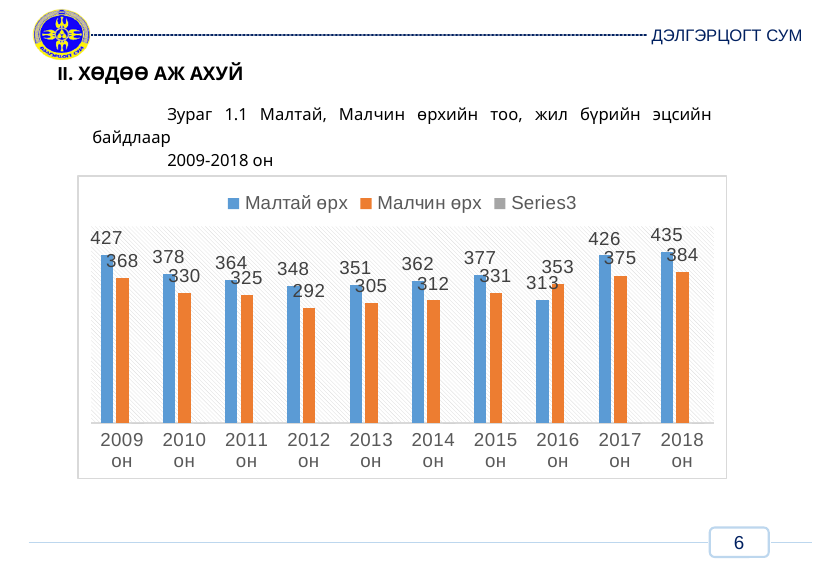
What is the difference between Малтай өрх and Малчин өрх in 2009 он? 59 In 2016 он, which is larger: Малтай өрх or Малчин өрх? Малчин өрх What is the value for Малчин өрх in 2018 он? 384 What is the value for Малчин өрх in 2012 он? 292 What is the value for Малтай өрх in 2009 он? 427 What is the difference between the Малтай өрх values for 2018 он and 2016 он? 122 What kind of chart is shown on the slide? bar chart In which year is the value for Малтай өрх highest? 2018 он In which year is the value for Малчин өрх lowest? 2012 он How many series does the legend list? 3 How many years are shown on the x axis? 10 Which colour represents Малчин өрх in the chart? orange